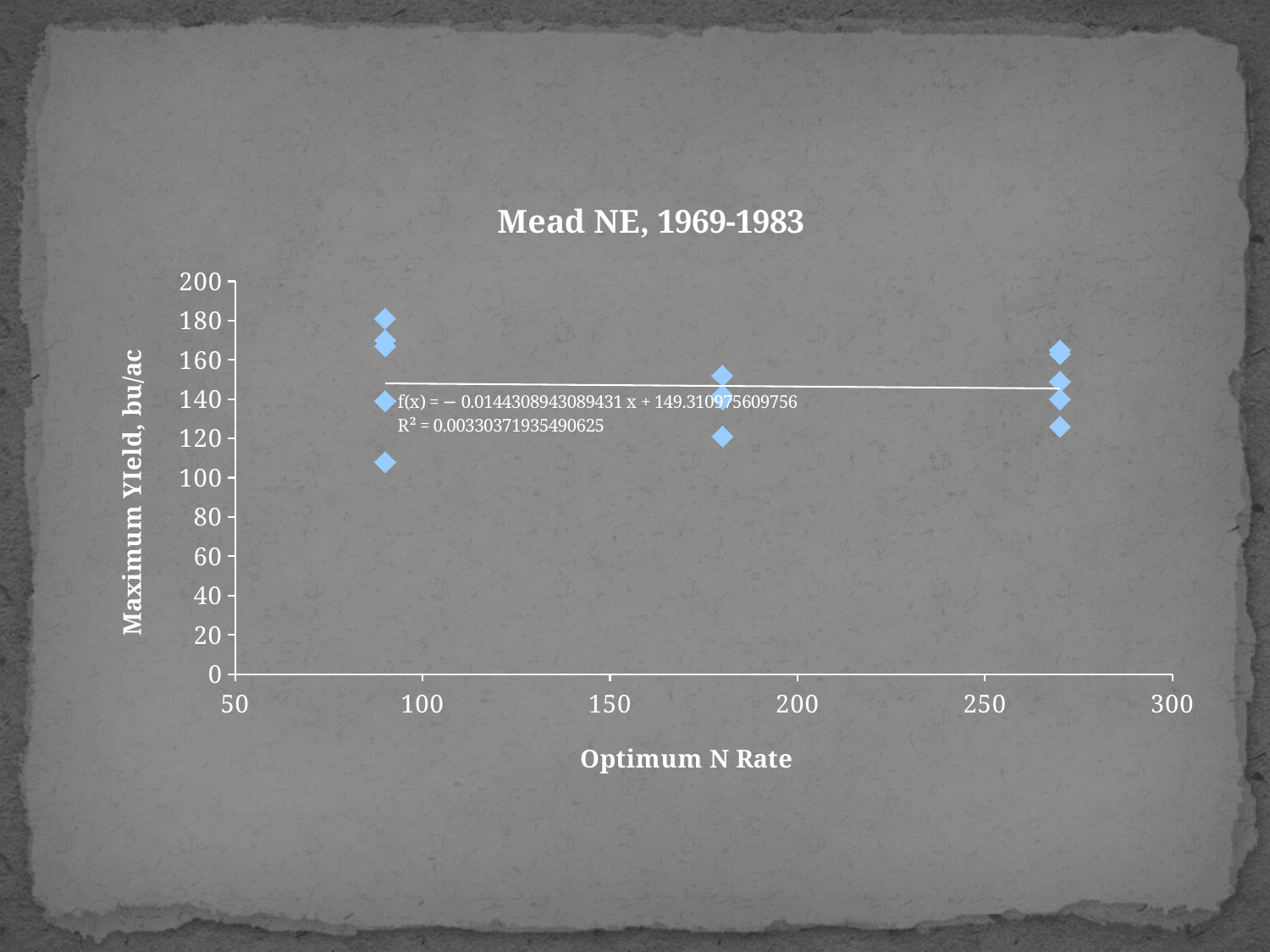
How many distinct Optimum N Rate values have points plotted? 3 Is the highest plotted Maximum Yield value greater or less than 160 bu/ac? greater Does the fitted trendline slope upward or downward as Optimum N Rate increases? downward What is the intercept of the fitted line equation shown on the chart? 149.310975609756 What is the title of the chart? Mead NE, 1969-1983 What kind of chart is shown on the slide? scatter chart What is the slope of the fitted line equation shown on the chart? −0.0144308943089431 What R² value is printed on the chart for the trendline? 0.00330371935490625 What is the label of the y axis? Maximum YIeld, bu/ac What is the maximum value shown on the y axis? 200 Is the lowest plotted Maximum Yield value greater or less than 120 bu/ac? less